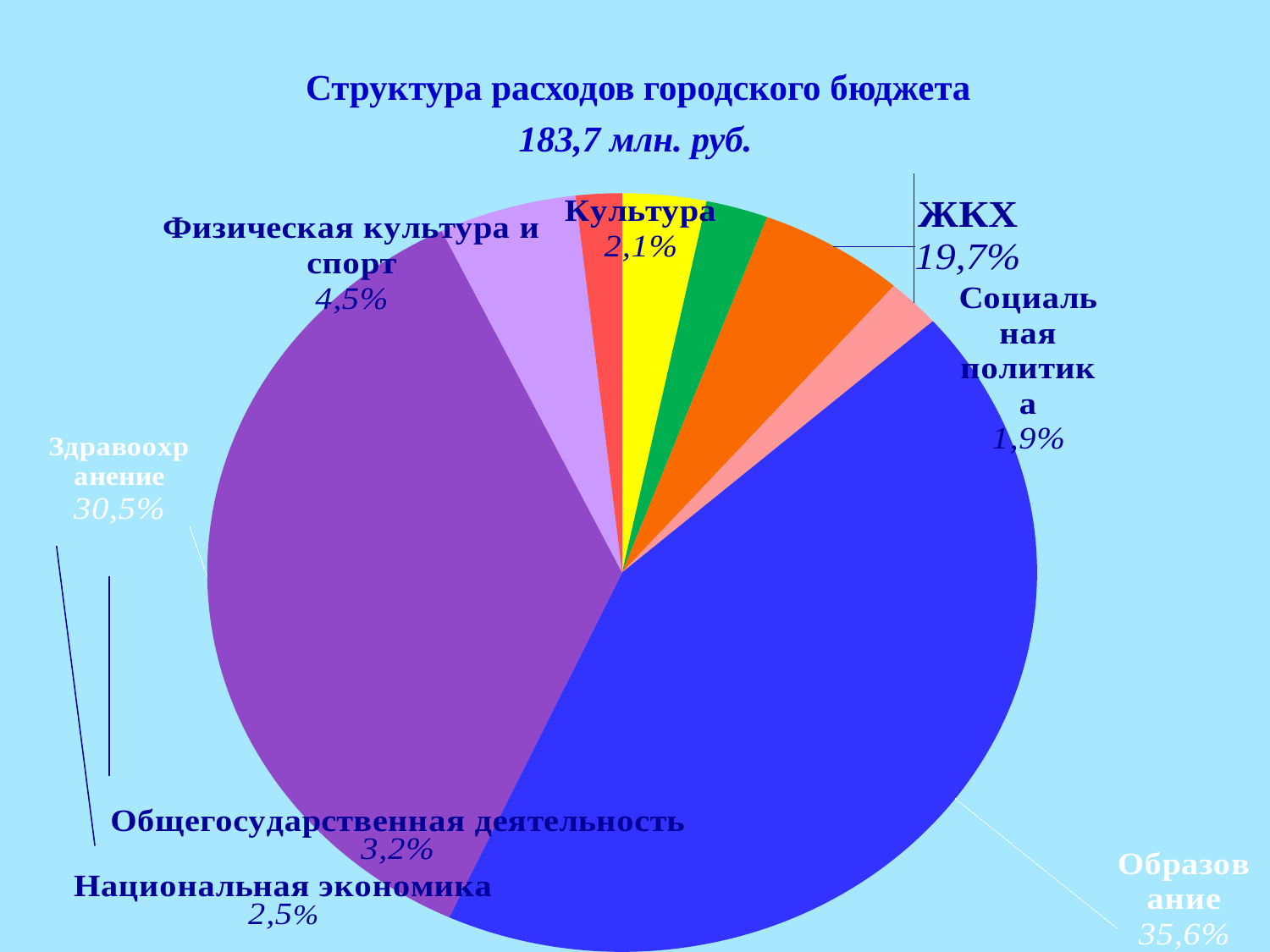
What total amount of city budget expenditure is stated under the chart title? 183,7 млн. руб. Which has a larger share of the budget, Общегосударственная деятельность or Национальная экономика? Общегосударственная деятельность How many expenditure categories are shown in the pie chart? 8 Which expenditure category has the smallest share of the city budget? Социальная политика What is the difference in percentage points between the shares of Образование and Здравоохранение? 5,1 What share of the city budget expenditure goes to Образование? 35,6% What share of the city budget expenditure goes to Здравоохранение? 30,5% What share of the city budget expenditure goes to Социальная политика? 1,9% What share of the city budget expenditure goes to Физическая культура и спорт? 4,5% Which expenditure category has the largest share of the city budget? Образование What kind of chart is shown on the slide? pie chart What share of the city budget expenditure goes to ЖКХ? 19,7%